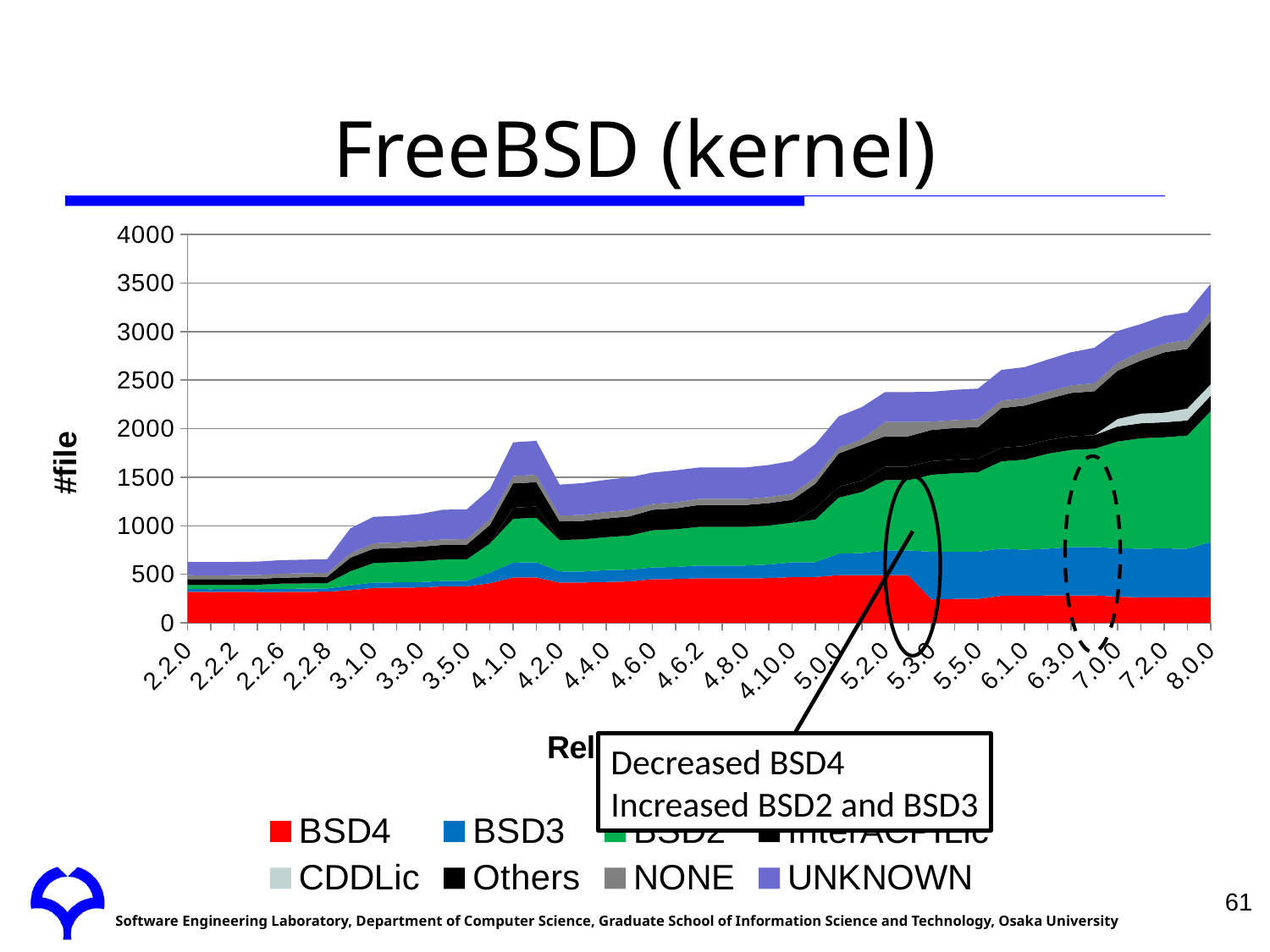
How many release versions are labelled along the x axis? 23 Which release has the highest total number of files? 8.0.0 Is the total number of files at release 5.3.0 greater or less than 2000? greater How many series does the legend list? 8 Is the total number of files at release 8.0.0 greater or less than 3000? greater What colour represents the BSD4 series in the legend? Red What is the label on the y axis? #file Does the total number of files generally rise or fall from release 2.2.0 to release 8.0.0? rise Is the total number of files at release 4.1.0 greater or less than 1500? greater What kind of chart is shown on the slide? Stacked area chart Which release has a larger total number of files, 4.1.0 or 4.2.0? 4.1.0